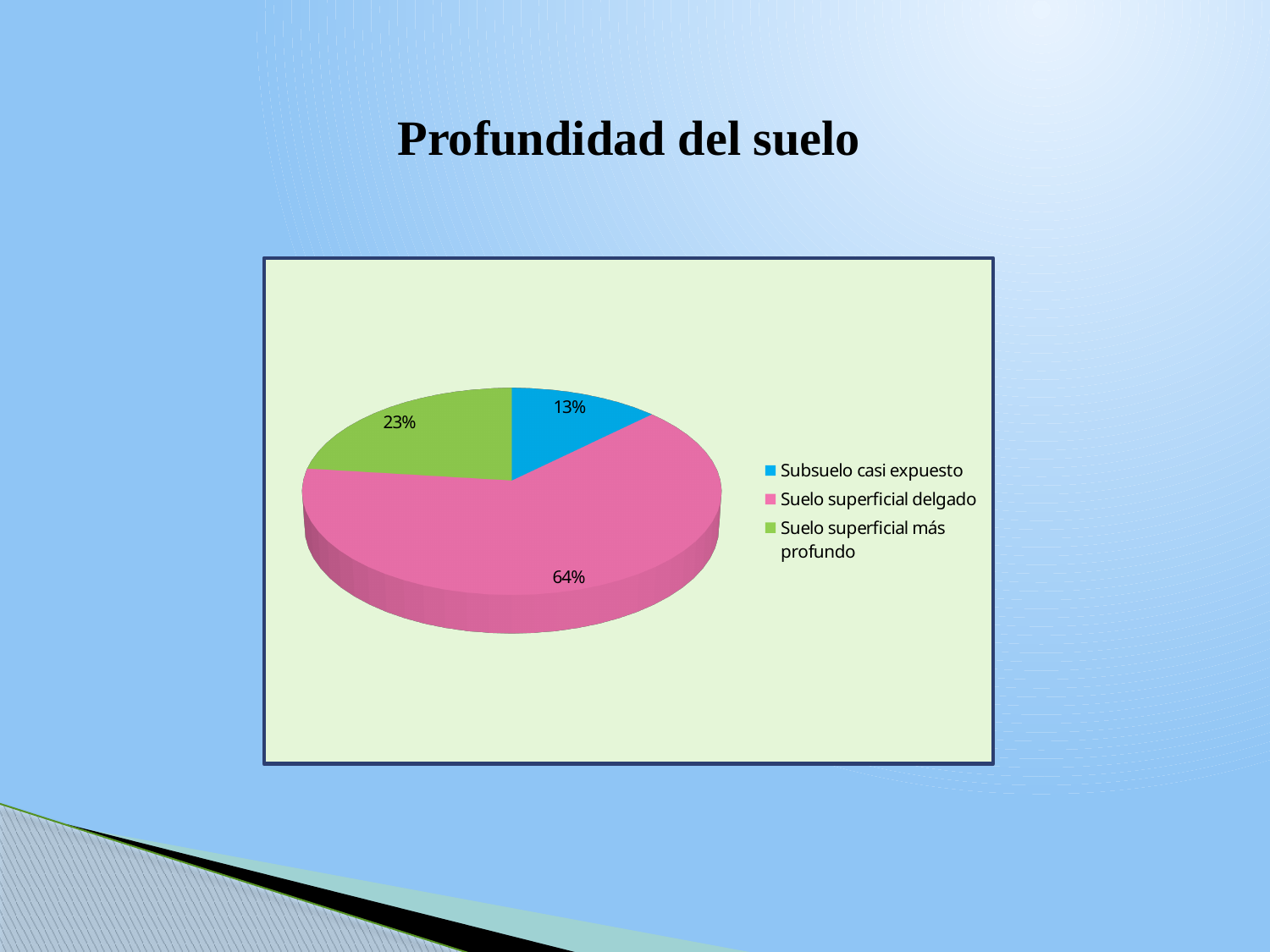
What share of the pie does "Subsuelo casi expuesto" represent? 13% Which category has the largest slice of the pie? Suelo superficial delgado Which category has the smallest slice of the pie? Subsuelo casi expuesto What colour is the slice for "Suelo superficial delgado"? Pink What share of the pie does "Suelo superficial más profundo" represent? 23% What is the difference in percentage points between "Suelo superficial más profundo" and "Subsuelo casi expuesto"? 10 What is the difference in percentage points between "Suelo superficial delgado" and "Suelo superficial más profundo"? 41 What kind of chart is shown on the slide? Pie chart Which is larger: the slice for "Suelo superficial más profundo" or the slice for "Subsuelo casi expuesto"? Suelo superficial más profundo What is the title of the chart on the slide? Profundidad del suelo What share of the pie does "Suelo superficial delgado" represent? 64% How many categories does the pie chart have? 3